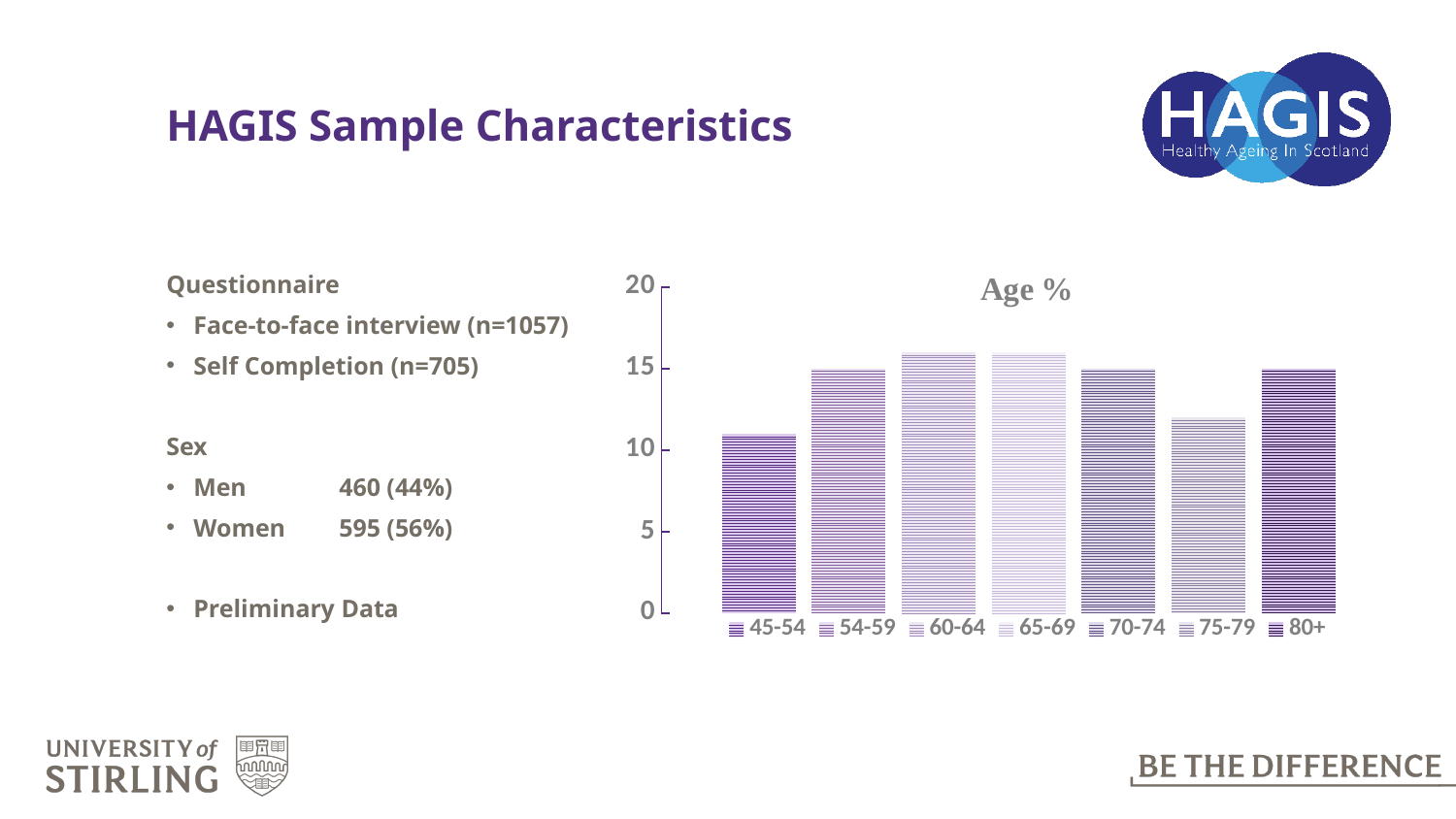
What is the title of the chart? Age % What kind of chart is shown on the slide? bar chart Which has the larger value, the 60-64 age group or the 75-79 age group? 60-64 Is the value for the 45-54 age group greater or less than 15? less Which has the larger value, the 54-59 age group or the 45-54 age group? 54-59 Which age category has the lowest value in the chart? 45-54 How many entries does the chart's legend list? 7 How many age categories are plotted in the chart? 7 Is the value for the 75-79 age group greater or less than 15? less Is the value for the 60-64 age group greater or less than 15? greater